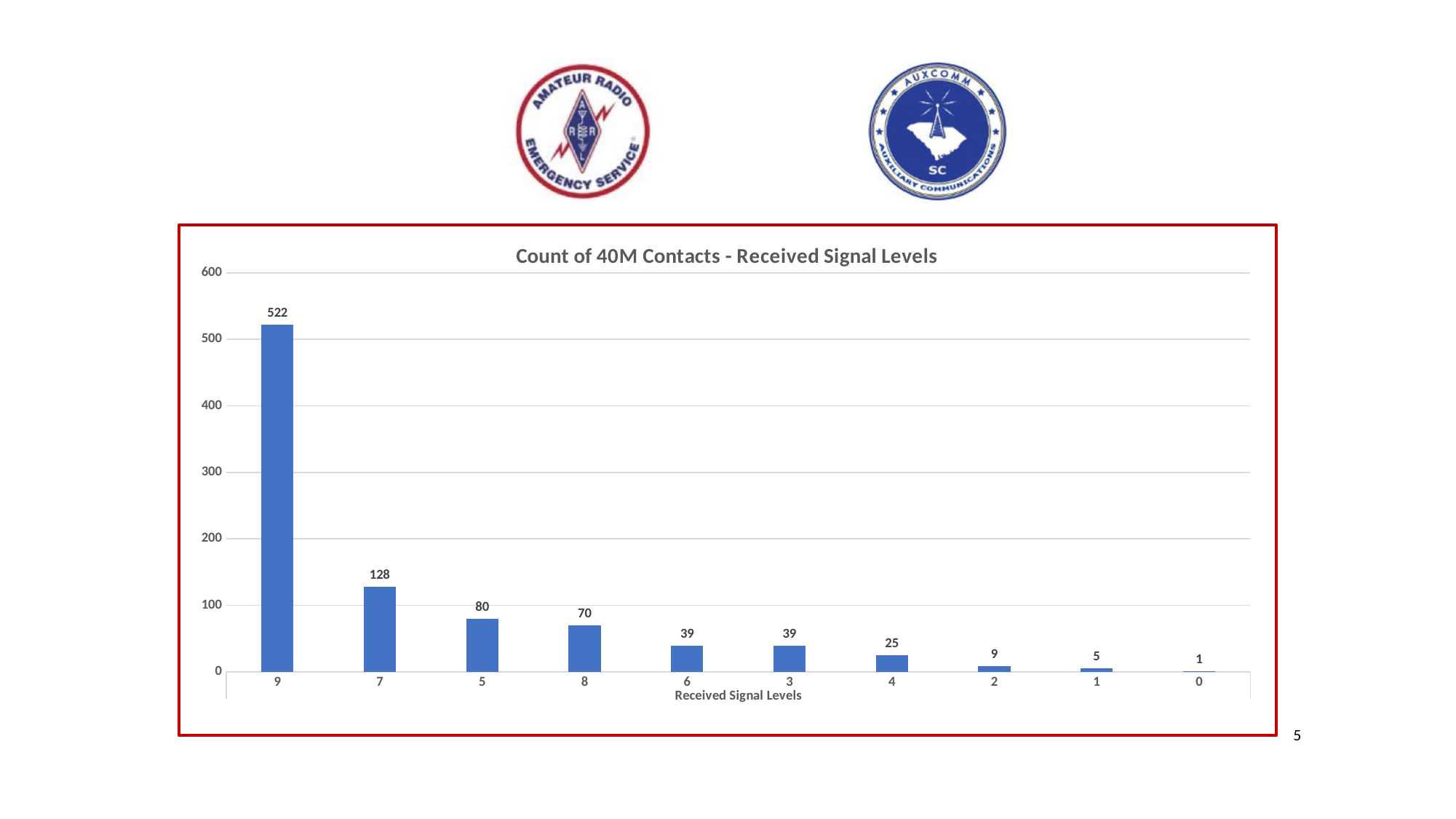
What kind of chart is shown on the slide? Bar chart What is the difference between the counts for signal level 5 and signal level 8? 10 How many received signal level categories are shown on the x axis? 10 What is the count of 40M contacts for received signal level 0? 1 What is the difference between the counts for signal level 9 and signal level 7? 394 What is the count of 40M contacts for received signal level 9? 522 What is the count of 40M contacts for received signal level 4? 25 What is the title of the chart? Count of 40M Contacts - Received Signal Levels What is the count of 40M contacts for received signal level 7? 128 Which has a larger count of contacts, signal level 8 or signal level 6? Signal level 8 Which received signal level has the lowest count of contacts? 0 Which received signal level has the highest count of contacts? 9